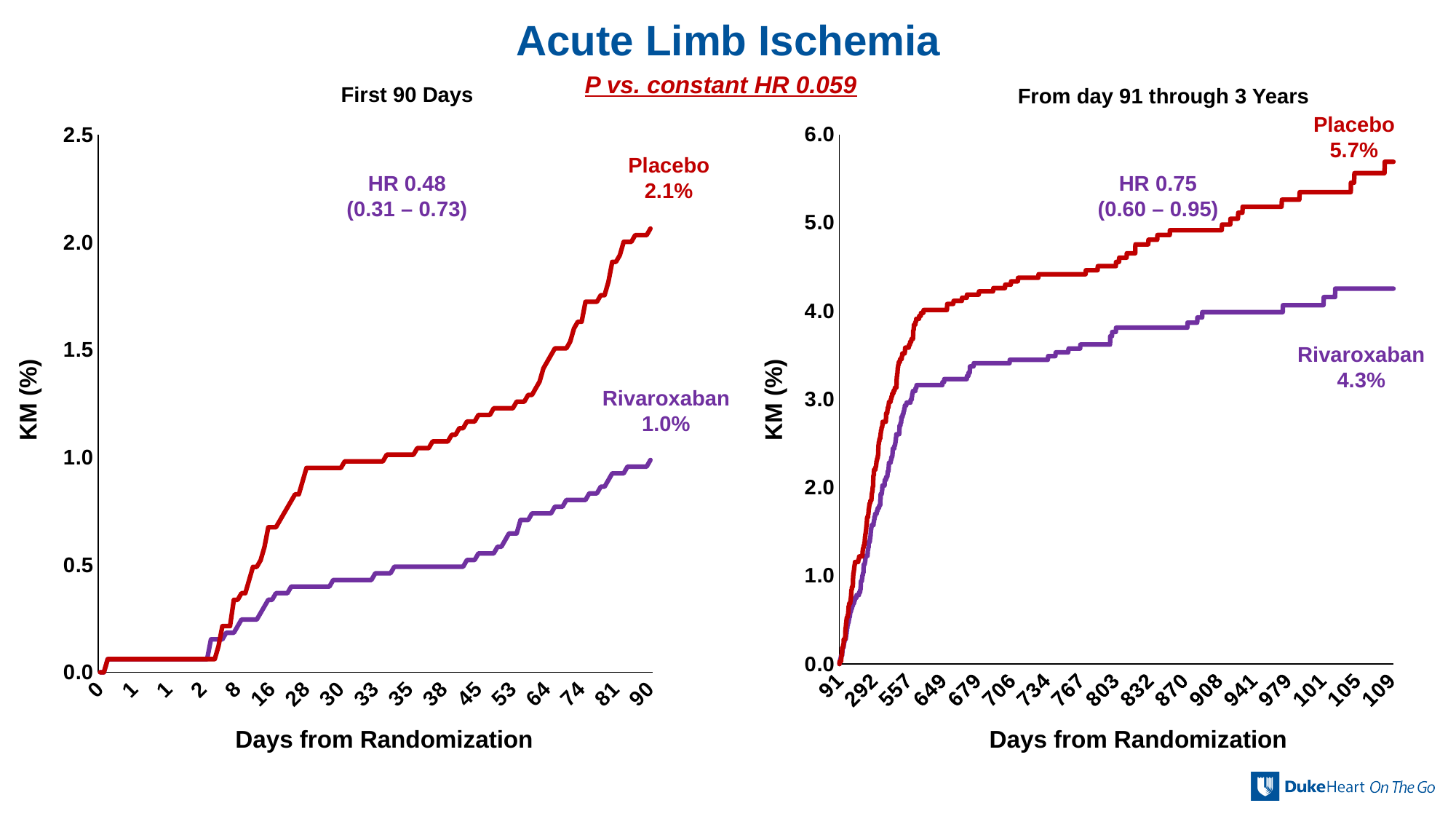
What hazard ratio is shown on the 'From day 91 through 3 Years' chart? HR 0.75 (0.60 – 0.95) What kind of chart is the 'First 90 Days' chart? Line chart In the 'From day 91 through 3 Years' chart, what is the KM value shown for Placebo? 5.7% In the 'From day 91 through 3 Years' chart, which group has the lower KM value, Placebo or Rivaroxaban? Rivaroxaban In the 'From day 91 through 3 Years' chart, what is the KM value shown for Rivaroxaban? 4.3% In the 'First 90 Days' chart, what is the KM value shown for Placebo at the end of the period? 2.1% In the 'From day 91 through 3 Years' chart, do the KM values rise or fall as days from randomization increase? Rise In the 'First 90 Days' chart, what is the KM value shown for Rivaroxaban at the end of the period? 1.0% How many groups (lines) are plotted in the 'First 90 Days' chart? 2 In the 'First 90 Days' chart, what is the difference between the Placebo and Rivaroxaban KM values at day 90? 1.1% In the 'First 90 Days' chart, which group has the higher KM value at day 90, Placebo or Rivaroxaban? Placebo In the 'From day 91 through 3 Years' chart, what is the difference between the Placebo and Rivaroxaban KM values? 1.4%